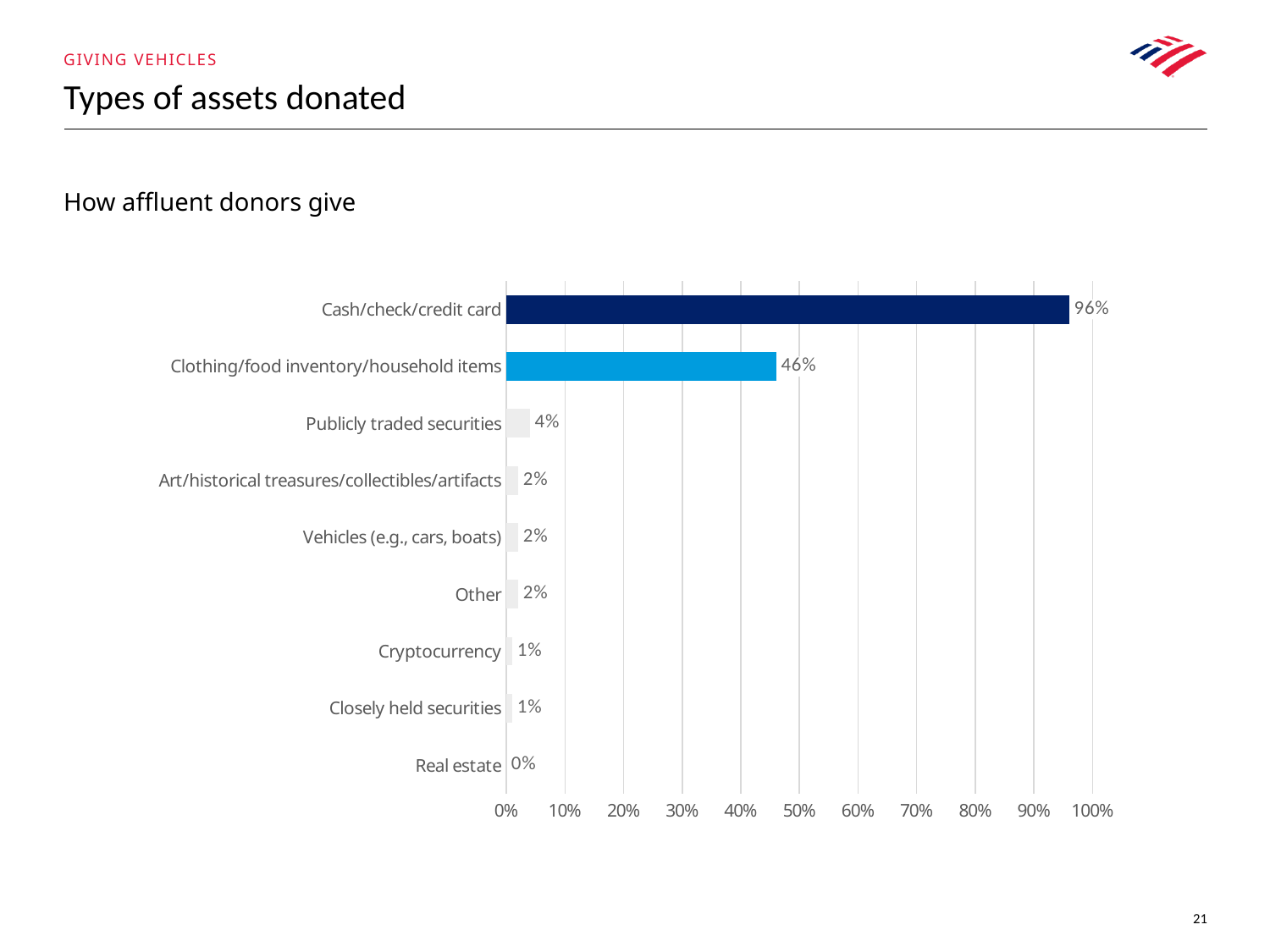
How many types of assets are shown in the chart? 9 What is the difference between the cash/check/credit card value and the clothing/food inventory/household items value? 50% What is the value for cryptocurrency? 1% What percentage is shown for publicly traded securities? 4% What is the value for clothing/food inventory/household items? 46% What is the value for real estate? 0% What percentage of affluent donors give via cash/check/credit card? 96% What kind of chart is shown on the slide? Bar chart Which type of asset has the lowest percentage? Real estate Which type of asset has the highest percentage? Cash/check/credit card What is the subtitle shown above the chart? How affluent donors give Which is larger, the value for publicly traded securities or the value for vehicles (e.g., cars, boats)? Publicly traded securities